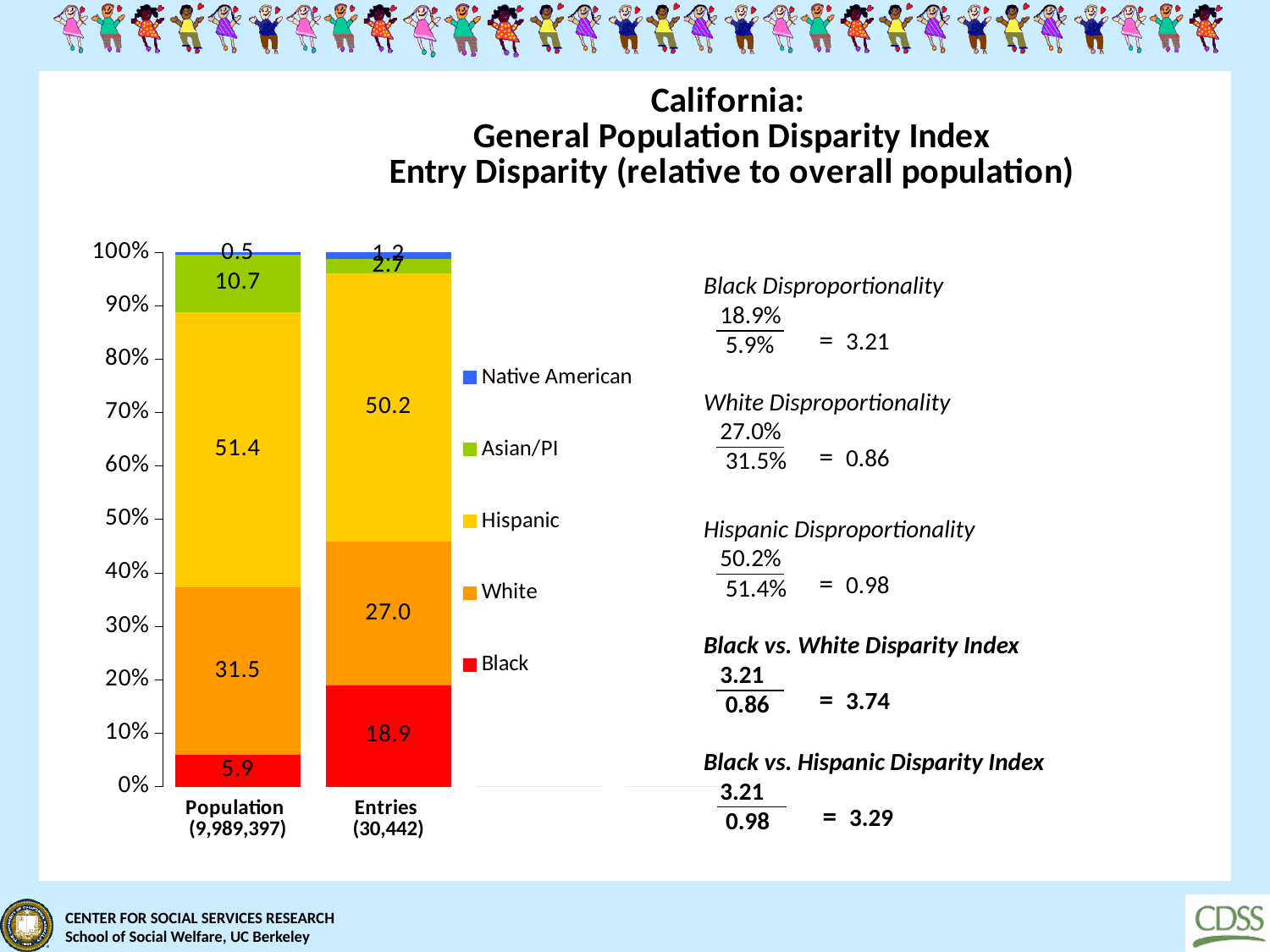
What type of chart is shown on the slide? Stacked bar chart Which group has the largest share of the Entries bar? Hispanic What is the Black share of the Entries bar? 18.9 What is the Asian/PI value for the Population bar? 10.7 How many series does the legend list? 5 What is the Hispanic value for the Entries bar? 50.2 Is the White share larger in the Population bar or the Entries bar? Population What is the Black share of the Population bar? 5.9 What is the difference between the Black share of Entries and the Black share of Population? 13.0 How many bars are plotted in the chart? 2 What is the White value for the Population bar? 31.5 Which group has the smallest share of the Population bar? Native American